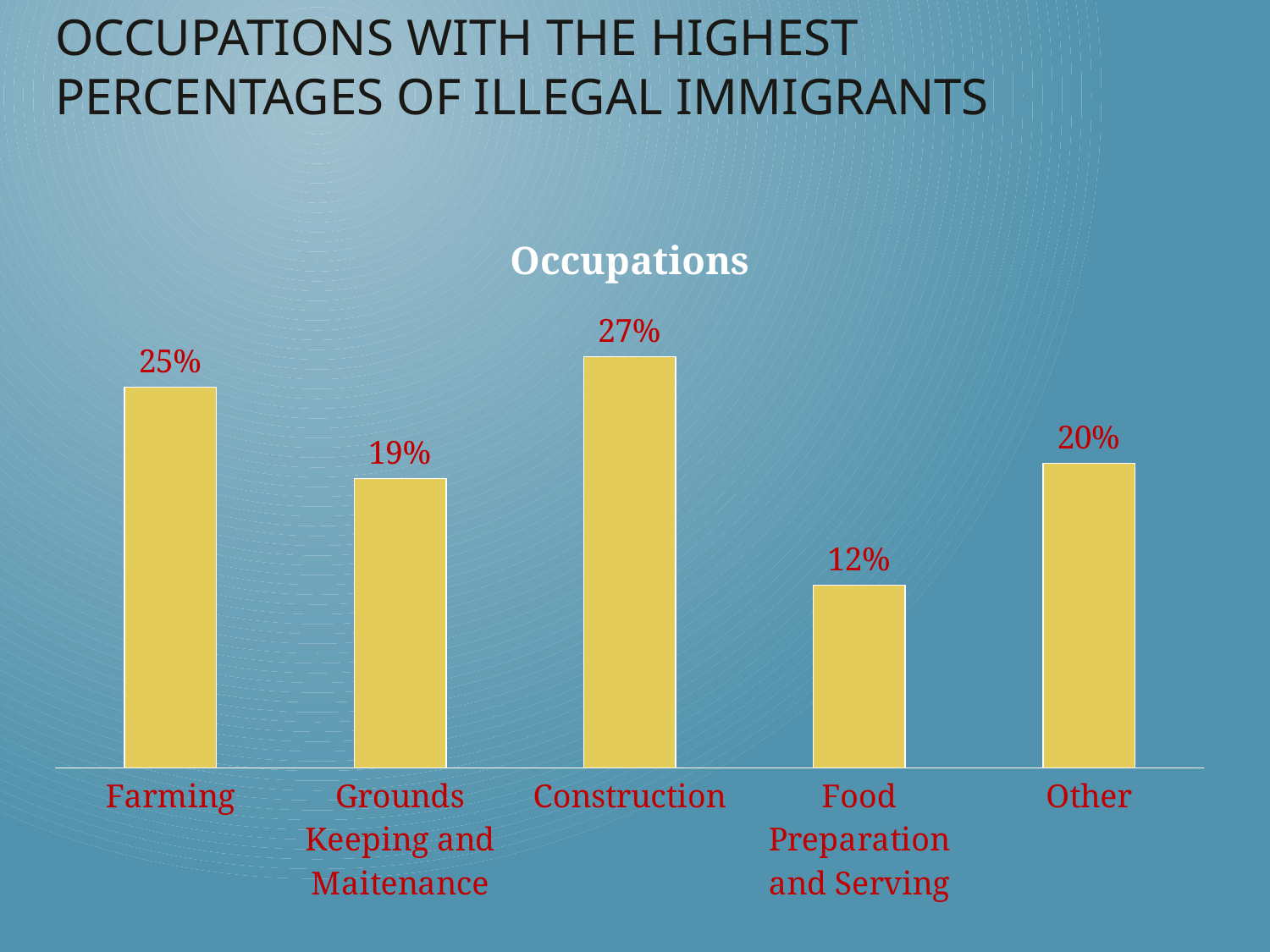
How many occupation categories are shown in the chart? 5 What is the value for Grounds Keeping and Maitenance? 19% What is the difference between the values for Construction and Farming? 2% What is the value for Farming? 25% What is the difference between the values for Other and Food Preparation and Serving? 8% What is the value for Construction? 27% What kind of chart is shown on the slide? Bar chart Which occupation has the highest value? Construction Which occupation has the lowest value? Food Preparation and Serving What is the value for Food Preparation and Serving? 12% What is the title of the chart? Occupations Which is larger, the value for Farming or the value for Other? Farming